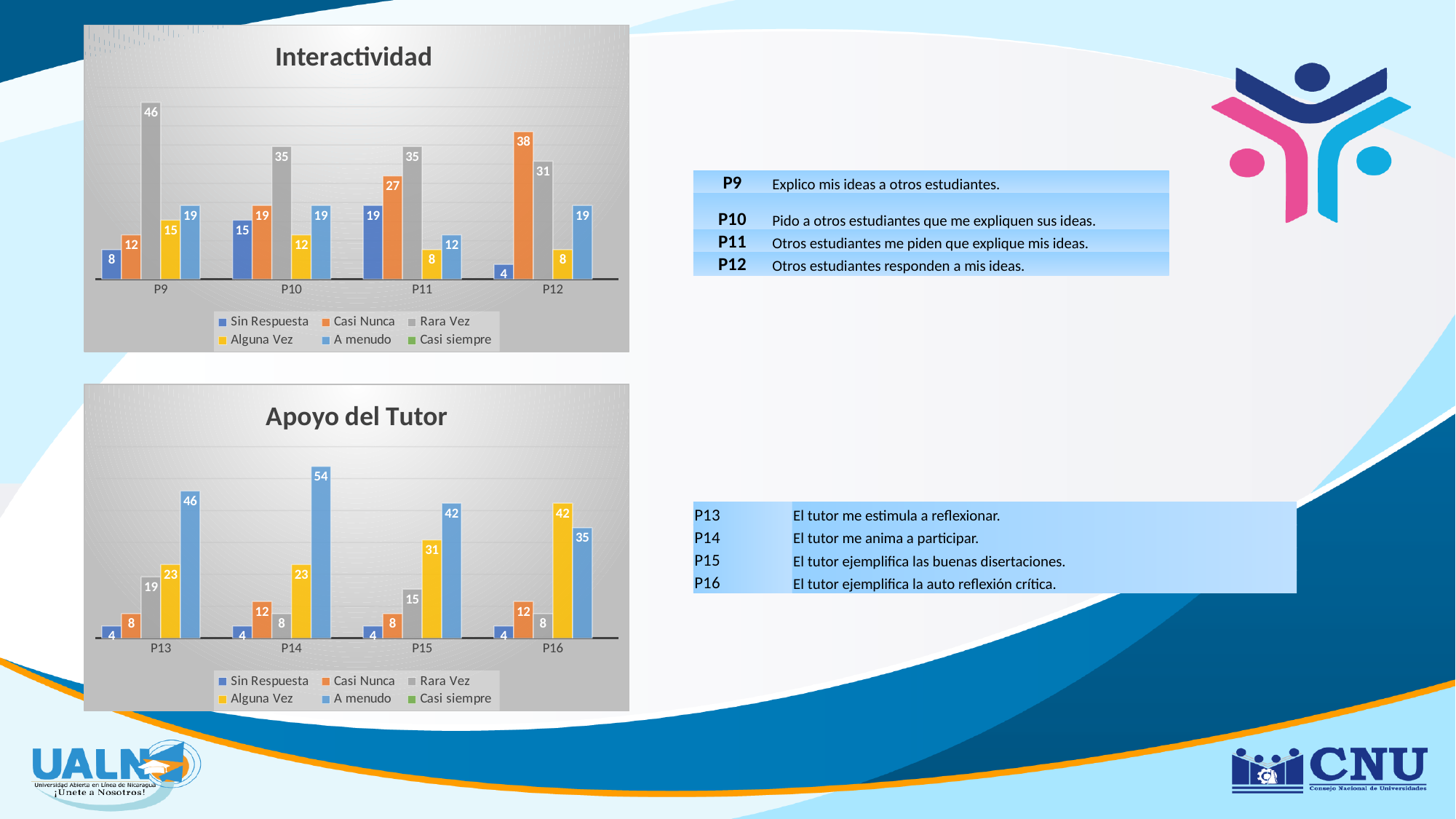
How many series does the legend of the Interactividad chart list? 6 In the Interactividad chart, what is the difference between the Rara Vez and Sin Respuesta values for P9? 38 In the Apoyo del Tutor chart, what is the value of Alguna Vez for P16? 42 In the Apoyo del Tutor chart, which category has the highest A menudo value? P14 How many categories are shown on the x axis of the Apoyo del Tutor chart? 4 In the Apoyo del Tutor chart, what is the value of A menudo for P14? 54 In the Interactividad chart, which is larger for P11: Casi Nunca or Rara Vez? Rara Vez In the Interactividad chart, what is the value of Rara Vez for P9? 46 In the Apoyo del Tutor chart, which is larger for P16: Alguna Vez or A menudo? Alguna Vez In the Interactividad chart, what is the value of Casi Nunca for P12? 38 In the Interactividad chart, which category has the highest Rara Vez value? P9 What kind of chart is the Apoyo del Tutor chart? bar chart